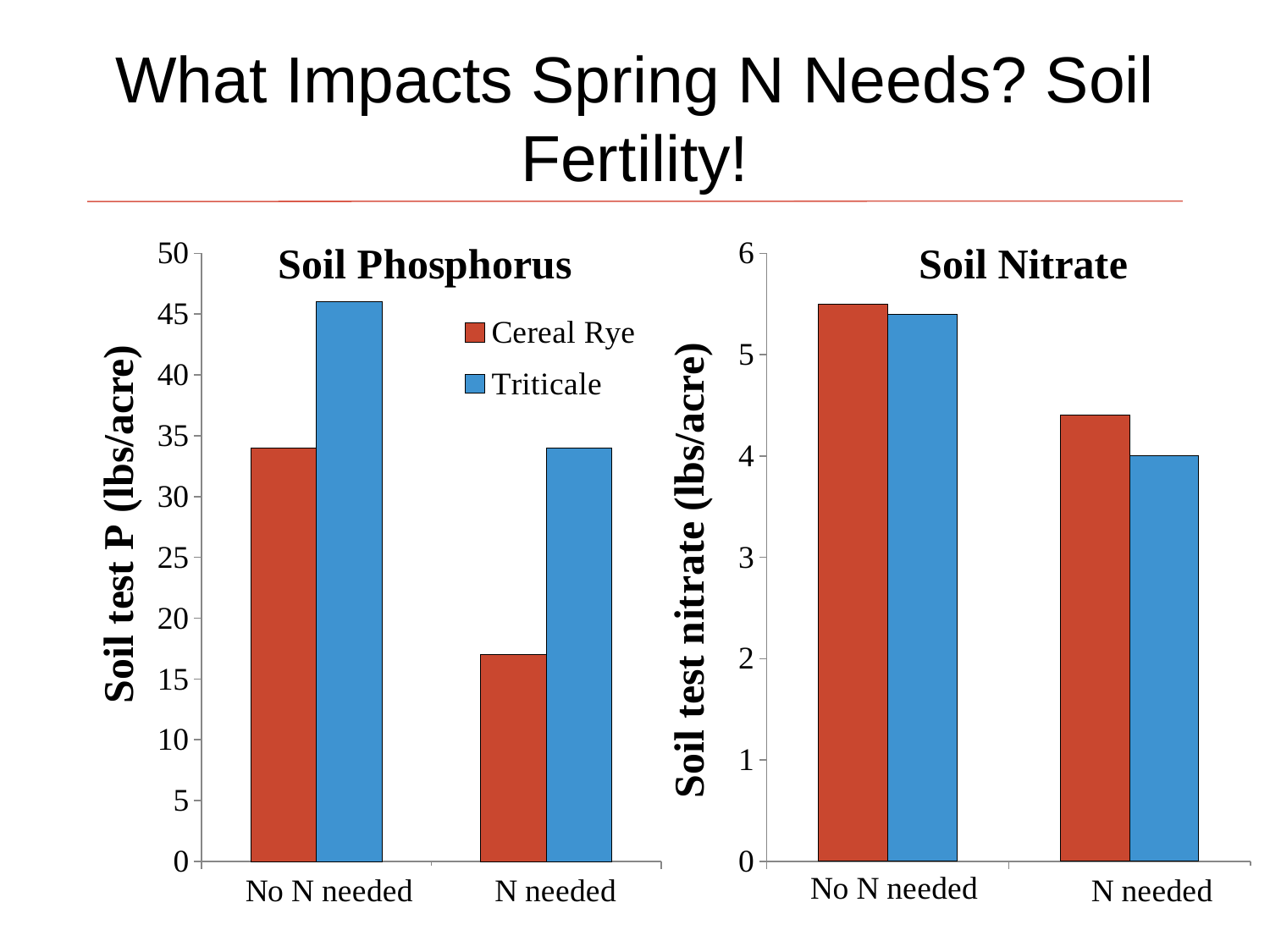
How many series does the legend of the Soil Phosphorus chart list? 2 How many categories are shown on the x axis of the Soil Nitrate chart? 2 In the Soil Phosphorus chart, which bar is the highest? Triticale, No N needed In the Soil Nitrate chart, do the Cereal Rye values rise or fall from No N needed to N needed? fall In the Soil Nitrate chart, for N needed, which is larger: Cereal Rye or Triticale? Cereal Rye In the Soil Phosphorus chart, which bar is the lowest? Cereal Rye, N needed In the Soil Phosphorus chart, is the Triticale value for No N needed greater or less than 40? greater In the Soil Phosphorus chart, for No N needed, which is larger: Cereal Rye or Triticale? Triticale In the Soil Nitrate chart, is the Cereal Rye value for No N needed greater or less than 5? greater In the Soil Phosphorus chart, is the Cereal Rye value for N needed greater or less than 20? less What kind of chart is the Soil Phosphorus chart? bar chart